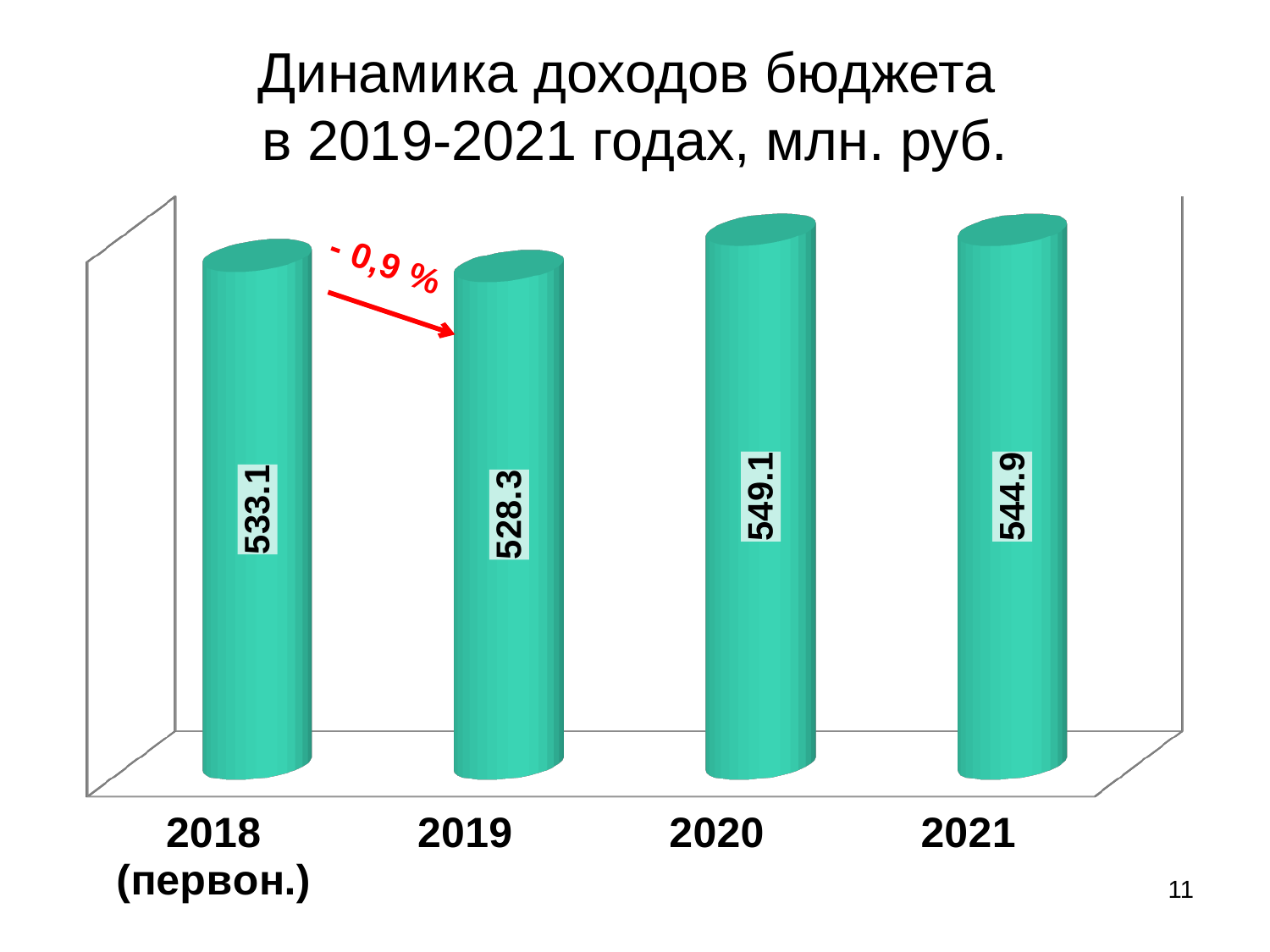
What is the title of the chart? Динамика доходов бюджета в 2019-2021 годах, млн. руб. How many categories are shown on the x axis? 4 What percentage change is shown by the red arrow between 2018 and 2019? - 0,9 % What is the value for 2019? 528.3 Which is larger, the value for 2020 or the value for 2021? 2020 What is the value for 2021? 544.9 What is the difference between the values for 2018 (первон.) and 2019? 4.8 What kind of chart is this? bar chart Which year has the lowest value? 2019 What is the difference between the values for 2020 and 2019? 20.8 Which year has the highest value? 2020 What is the value for 2018 (первон.)? 533.1